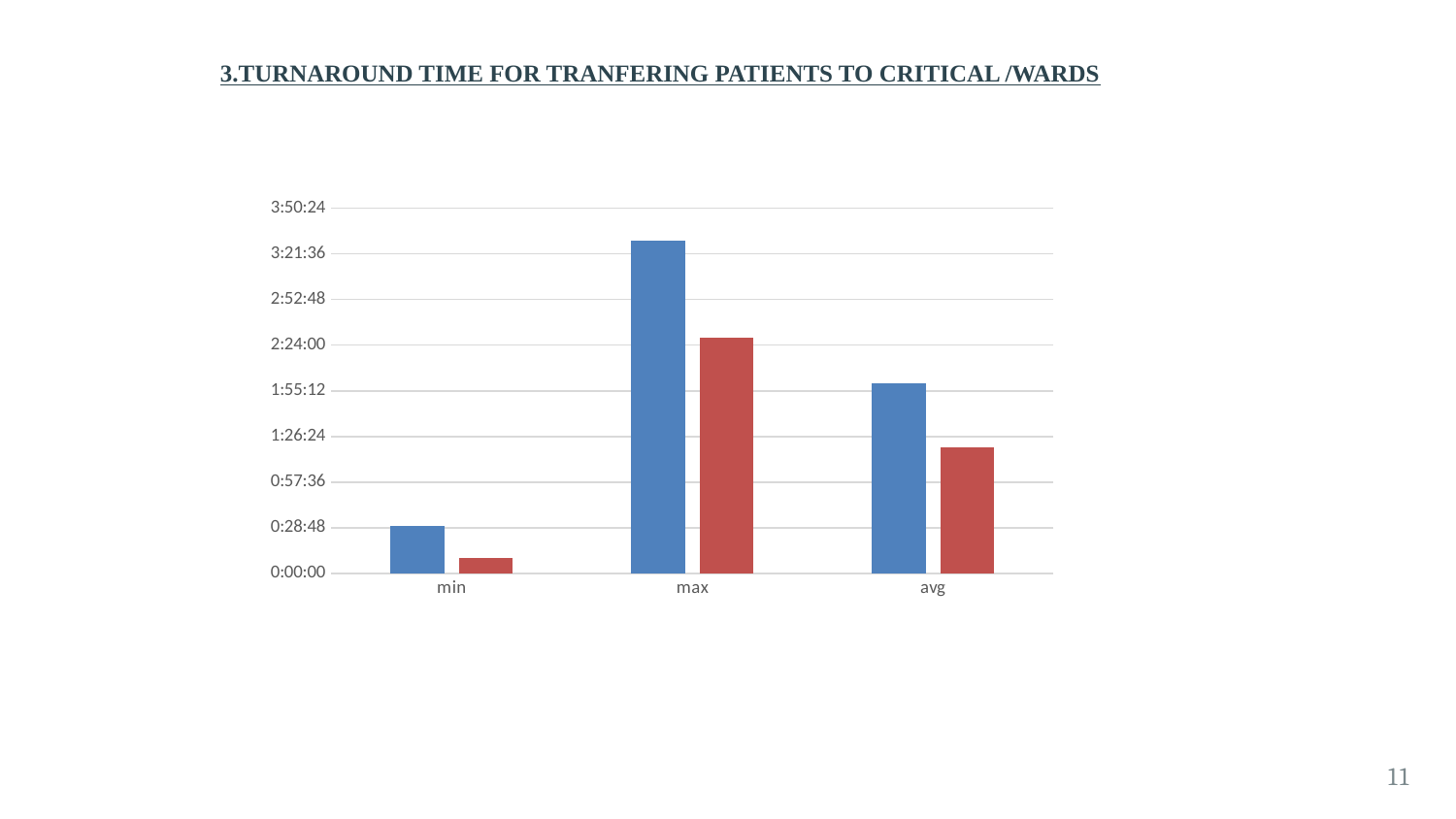
Is the red bar for avg greater or less than 0:57:36? greater Which category has the tallest blue bar? max Is the blue bar for max greater or less than 2:52:48? greater For the max category, which bar is taller, the blue one or the red one? the blue one Which category has the shortest red bar? min How many categories are shown on the x axis? 3 Is the red bar for max greater or less than 1:55:12? greater How many bars are plotted for each category? 2 What is the title of the slide above the chart? 3.TURNAROUND TIME FOR TRANFERING PATIENTS TO CRITICAL /WARDS What kind of chart is shown on the slide? bar chart